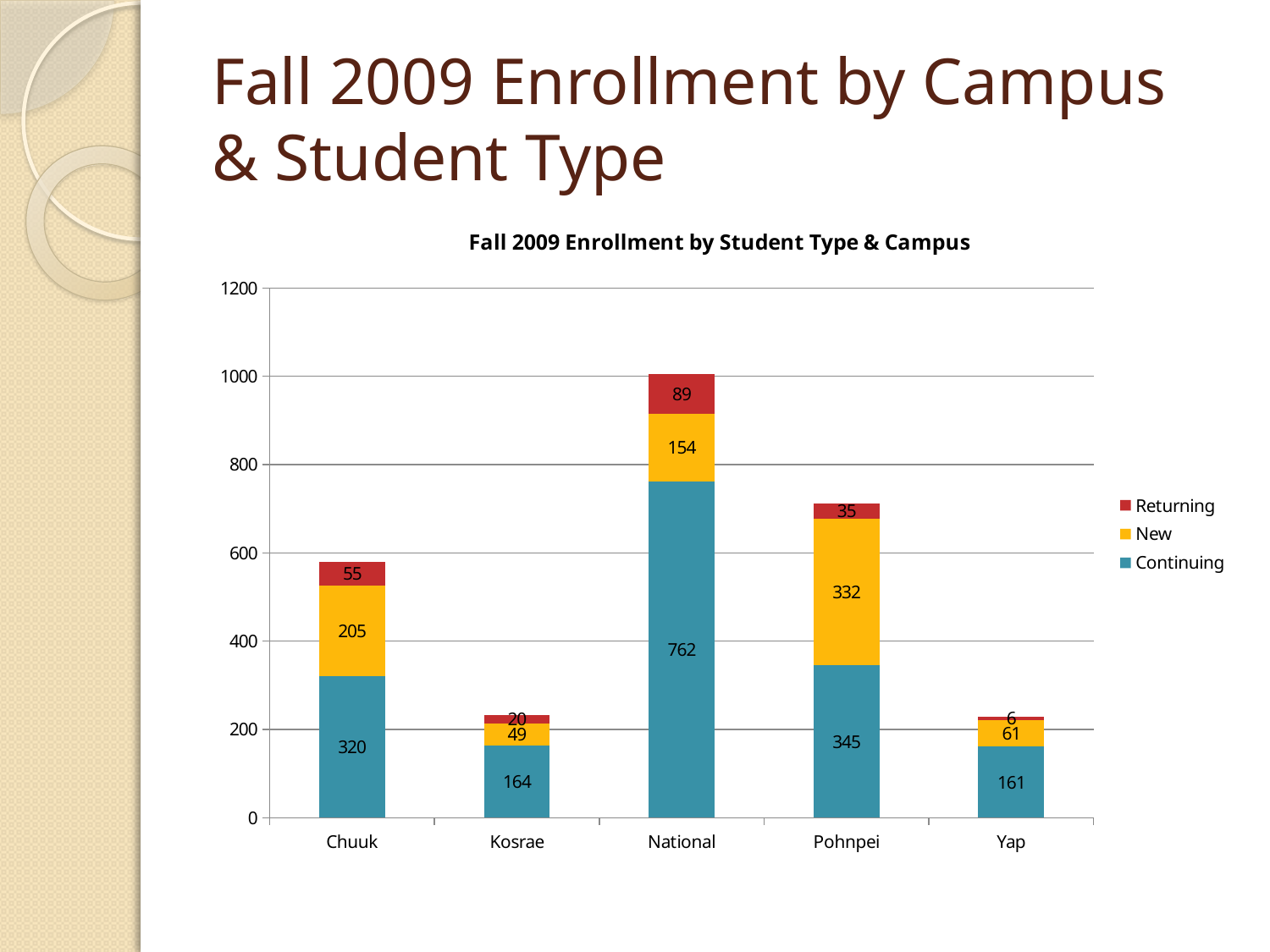
How many campuses are shown on the x axis? 5 What is the difference between the New enrollment for Pohnpei and the New enrollment for Chuuk? 127 What is the total enrollment for Kosrae across all three student types? 233 Which is larger, the Returning enrollment for Chuuk or the Returning enrollment for Pohnpei? Chuuk What is the Continuing enrollment for National? 762 What is the New enrollment for Pohnpei? 332 What is the total enrollment for National across all three student types? 1005 Which campus has the lowest New enrollment? Kosrae Which campus has the highest Continuing enrollment? National What is the Returning enrollment for Yap? 6 What kind of chart is this? Stacked bar chart How many series does the legend list? 3